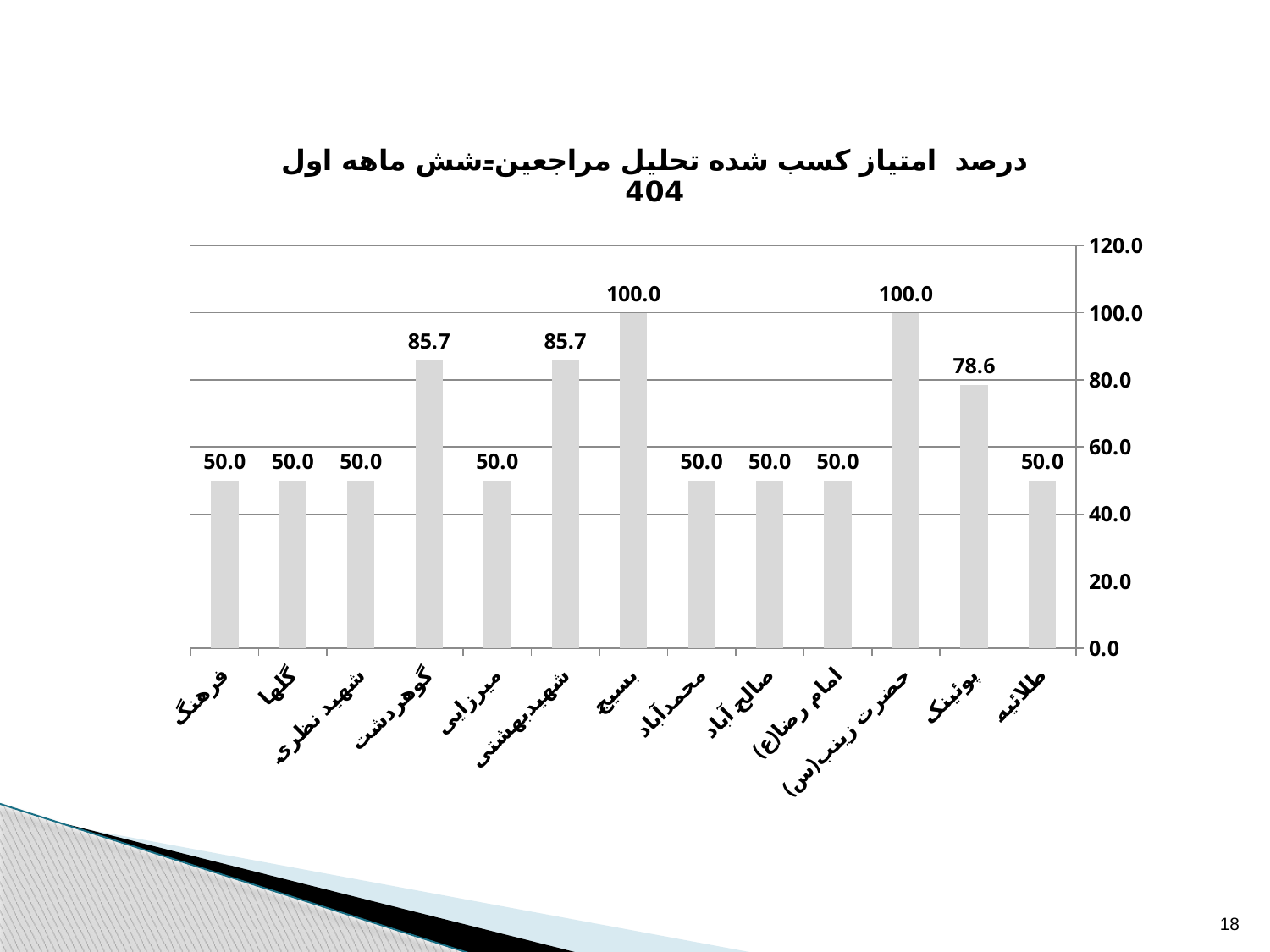
What is the value for طلائیه? 50.0 What is the maximum value shown on the vertical axis? 120.0 Which categories have the highest value? بسیج and حضرت زینب(س) What is the difference between the values for گوهردشت and فرهنگ? 35.7 What is the difference between the values for بسیج and پوئینک? 21.4 Is the value for پوئینک greater or less than 60.0? greater What is the value for شهیدبهشتی? 85.7 What kind of chart is shown on the slide? Bar chart How many categories are shown on the x axis? 13 What is the value for پوئینک? 78.6 What is the value for گوهردشت? 85.7 Which is larger, the value for پوئینک or the value for محمدآباد? پوئینک